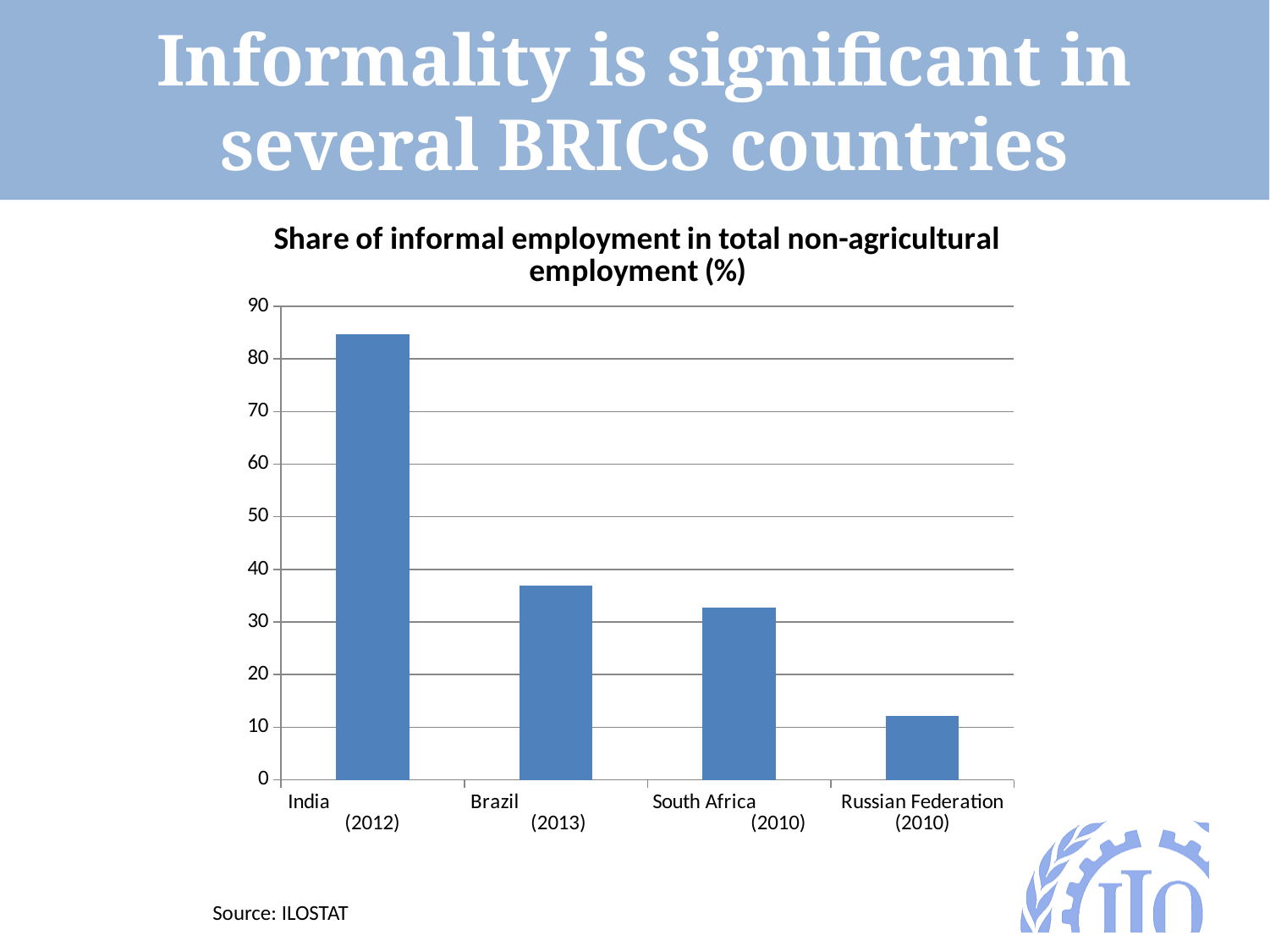
Which country has the highest share of informal employment in total non-agricultural employment? India What is the title of the chart? Share of informal employment in total non-agricultural employment (%) What kind of chart is shown on the slide? bar chart Is the value for South Africa greater or less than 30? greater Which has a higher share of informal employment, India or Brazil? India Which country has the lowest share of informal employment in total non-agricultural employment? Russian Federation How many countries are shown in the chart? 4 Is the value for India greater or less than 80? greater Is the value for Brazil greater or less than 40? less Do the values rise or fall moving from left to right across the countries? fall Which has a higher share of informal employment, South Africa or the Russian Federation? South Africa